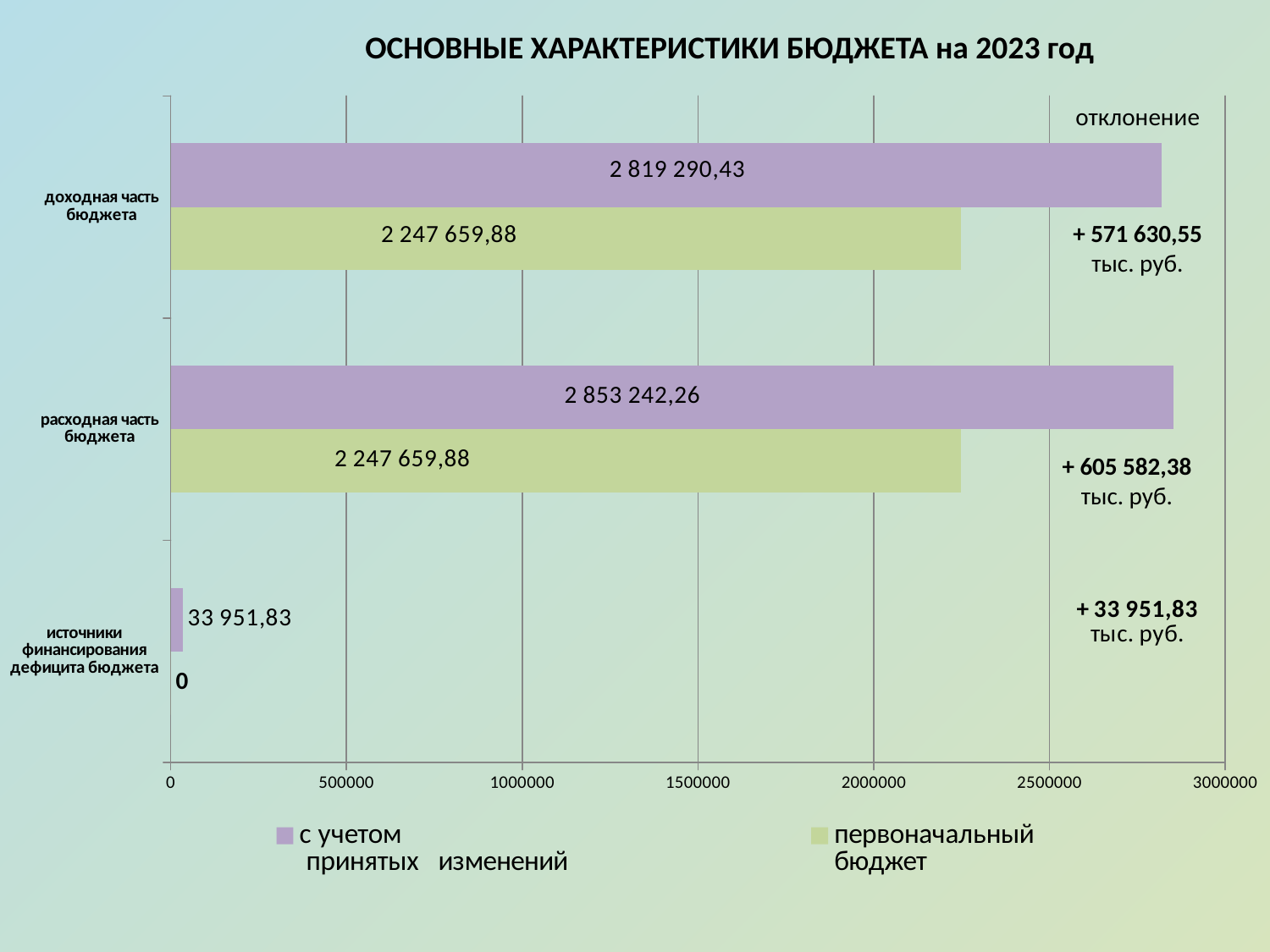
How many categories are shown on the chart? 3 What is the value for 'источники финансирования дефицита бюджета' in the 'первоначальный бюджет' series? 0 What is the value for 'источники финансирования дефицита бюджета' in the 'с учетом принятых изменений' series? 33 951,83 Which is larger for 'доходная часть бюджета': the 'с учетом принятых изменений' value or the 'первоначальный бюджет' value? с учетом принятых изменений Which category has the lowest value in the 'первоначальный бюджет' series? источники финансирования дефицита бюджета How many series does the legend list? 2 What type of chart is shown on the slide? Bar chart What is the difference between the 'с учетом принятых изменений' and 'первоначальный бюджет' values for 'расходная часть бюджета'? 605 582,38 What is the title of the chart? ОСНОВНЫЕ ХАРАКТЕРИСТИКИ БЮДЖЕТА на 2023 год Which category has the highest value in the 'с учетом принятых изменений' series? расходная часть бюджета What is the value for 'доходная часть бюджета' in the 'с учетом принятых изменений' series? 2 819 290,43 What is the value for 'расходная часть бюджета' in the 'первоначальный бюджет' series? 2 247 659,88